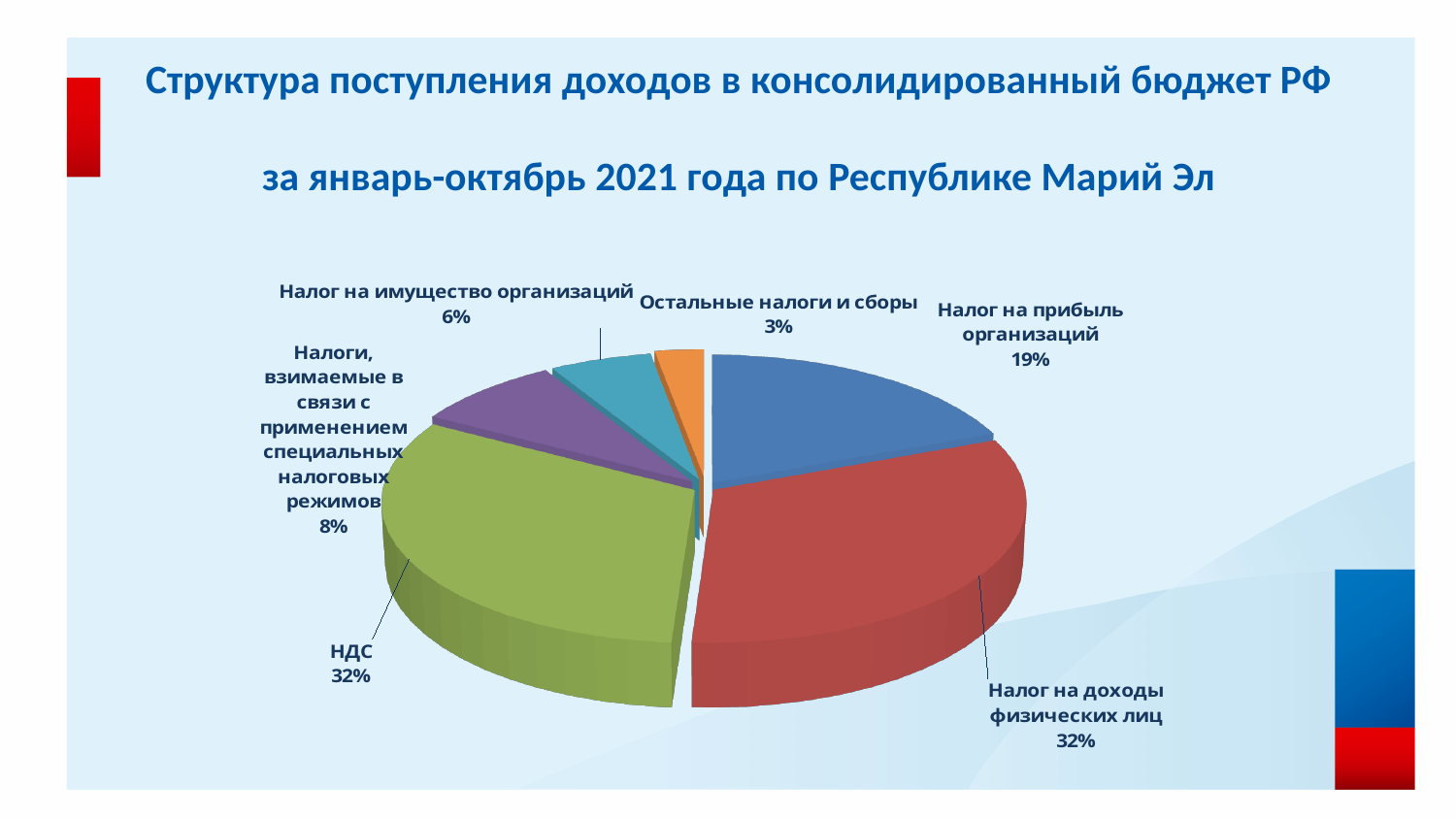
What share of the pie is labelled for Налог на имущество организаций? 6% What share of the pie is labelled for Остальные налоги и сборы? 3% What share of the pie is labelled for Налог на прибыль организаций? 19% How many slices does the pie chart have? 6 What is the difference in percentage points between Налог на доходы физических лиц and Налог на прибыль организаций? 13 What kind of chart is shown on the slide? Pie chart Which category has the smallest slice of the pie? Остальные налоги и сборы Which is larger: the share for Налог на имущество организаций or the share for Остальные налоги и сборы? Налог на имущество организаций What period does the chart title say the data covers? январь-октябрь 2021 года